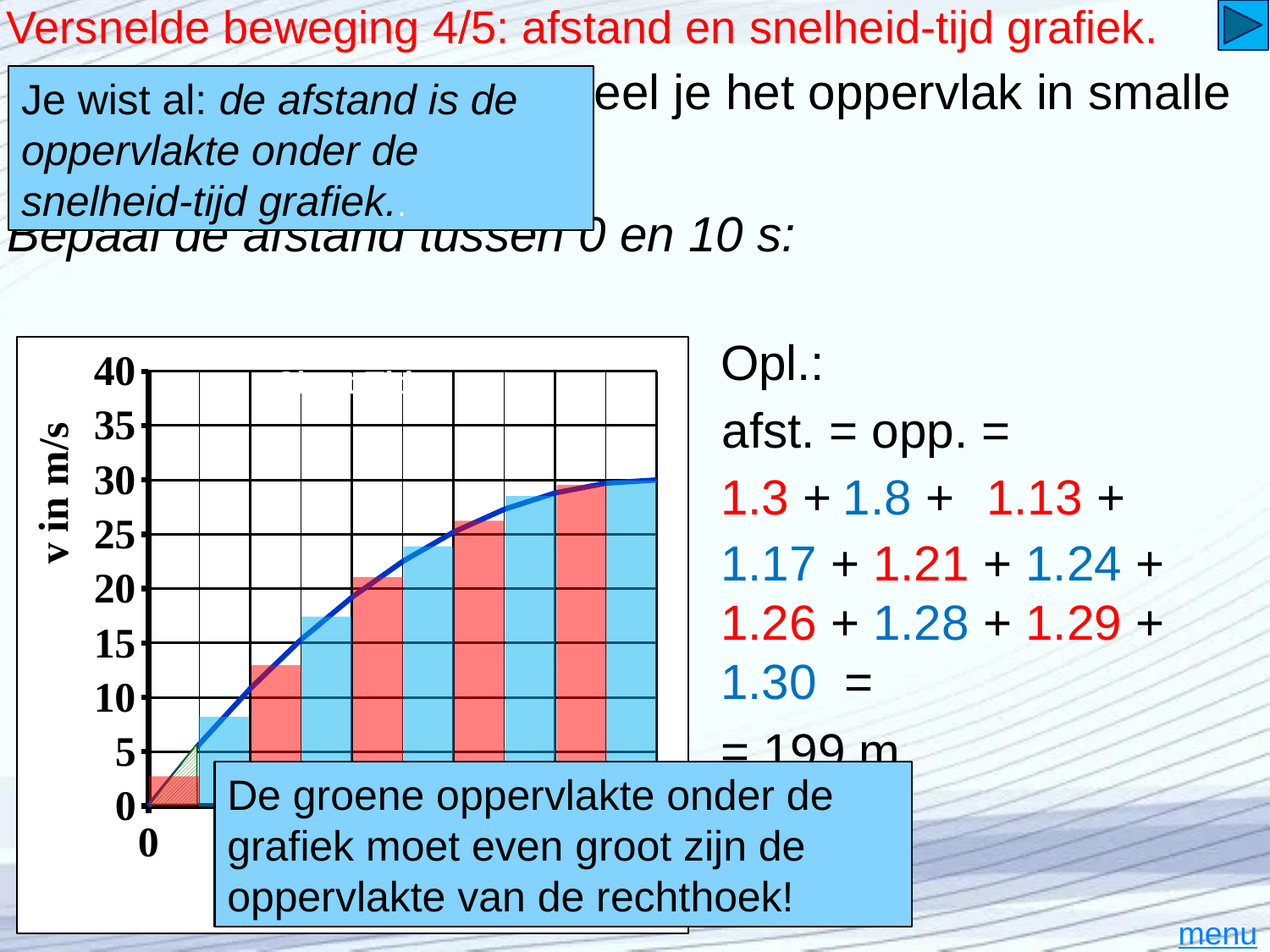
Is the rightmost bar taller or shorter than the leftmost bar? taller What is the label on the vertical axis of the chart? v in m/s Do the bar heights rise or fall from left to right along the x axis? rise Is the value of the second bar from the left greater or less than 5? greater What value does the curve reach at the right edge of the chart? 30 Is the maximum value reached by the curve greater or less than 35? less Which bar is the tallest, the leftmost or the rightmost? rightmost How many bars are drawn under the curve in the chart? 10 Is the value of the rightmost bar greater or less than 25? greater Which bar is the shortest in the chart? the leftmost bar What is the highest tick value shown on the vertical axis? 40